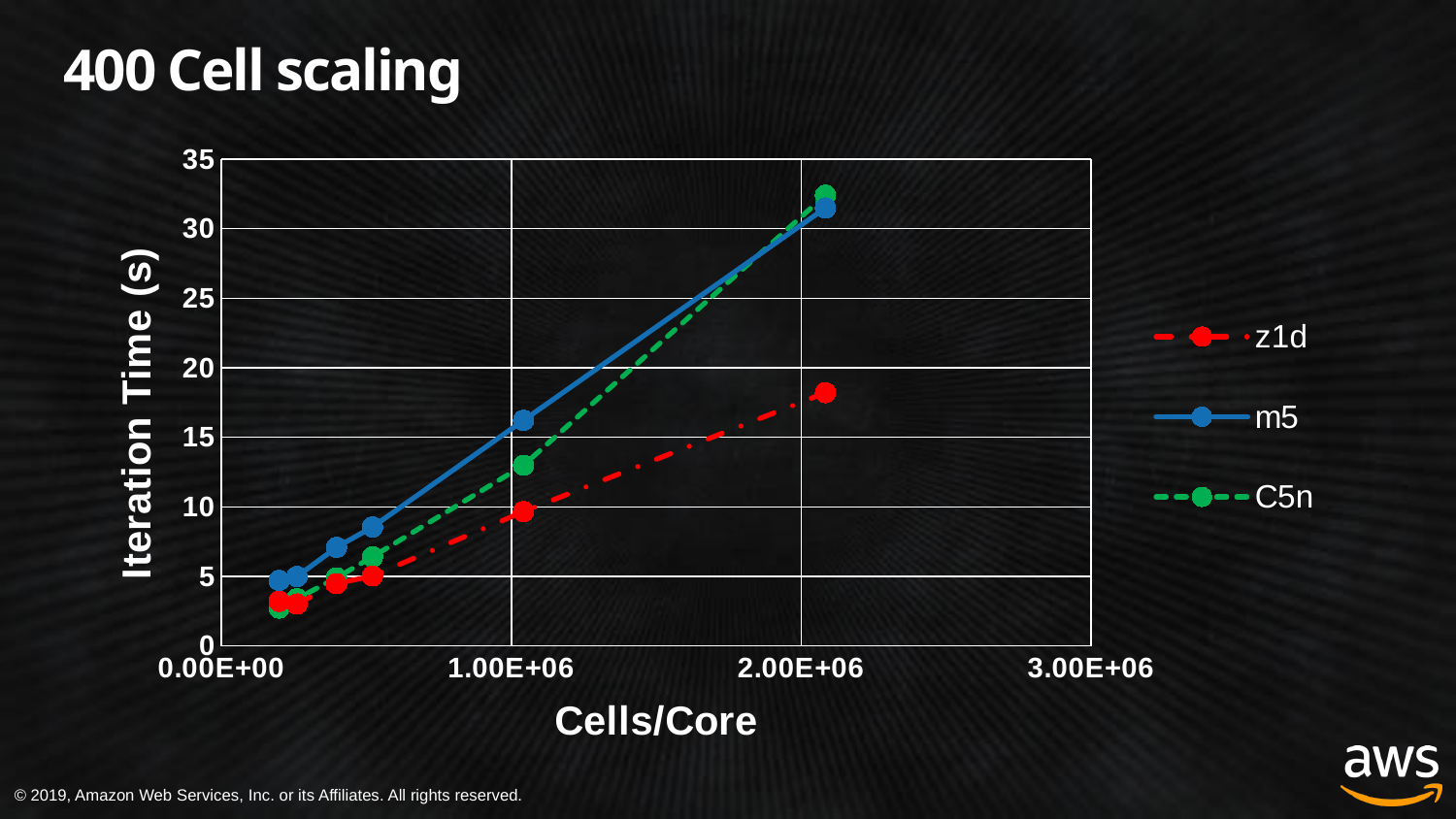
At roughly 1.00E+06 Cells/Core, which series has the larger iteration time, m5 or C5n? m5 Is the iteration time for C5n at its highest Cells/Core point greater or less than 30? greater Does the iteration time for the z1d series rise or fall as Cells/Core increases? rise Which series has the lowest iteration time at the highest Cells/Core value plotted? z1d At the highest Cells/Core value plotted, which series has the larger iteration time, m5 or z1d? m5 What kind of chart is shown on the slide? line chart What is the label of the y axis? Iteration Time (s) Is the iteration time for z1d at its highest Cells/Core point greater or less than 15? greater How many series does the legend list? 3 Is the iteration time for C5n at roughly 1.00E+06 Cells/Core greater or less than 15? less What is the title of the chart? 400 Cell scaling Does the iteration time for the m5 series rise or fall as Cells/Core increases? rise